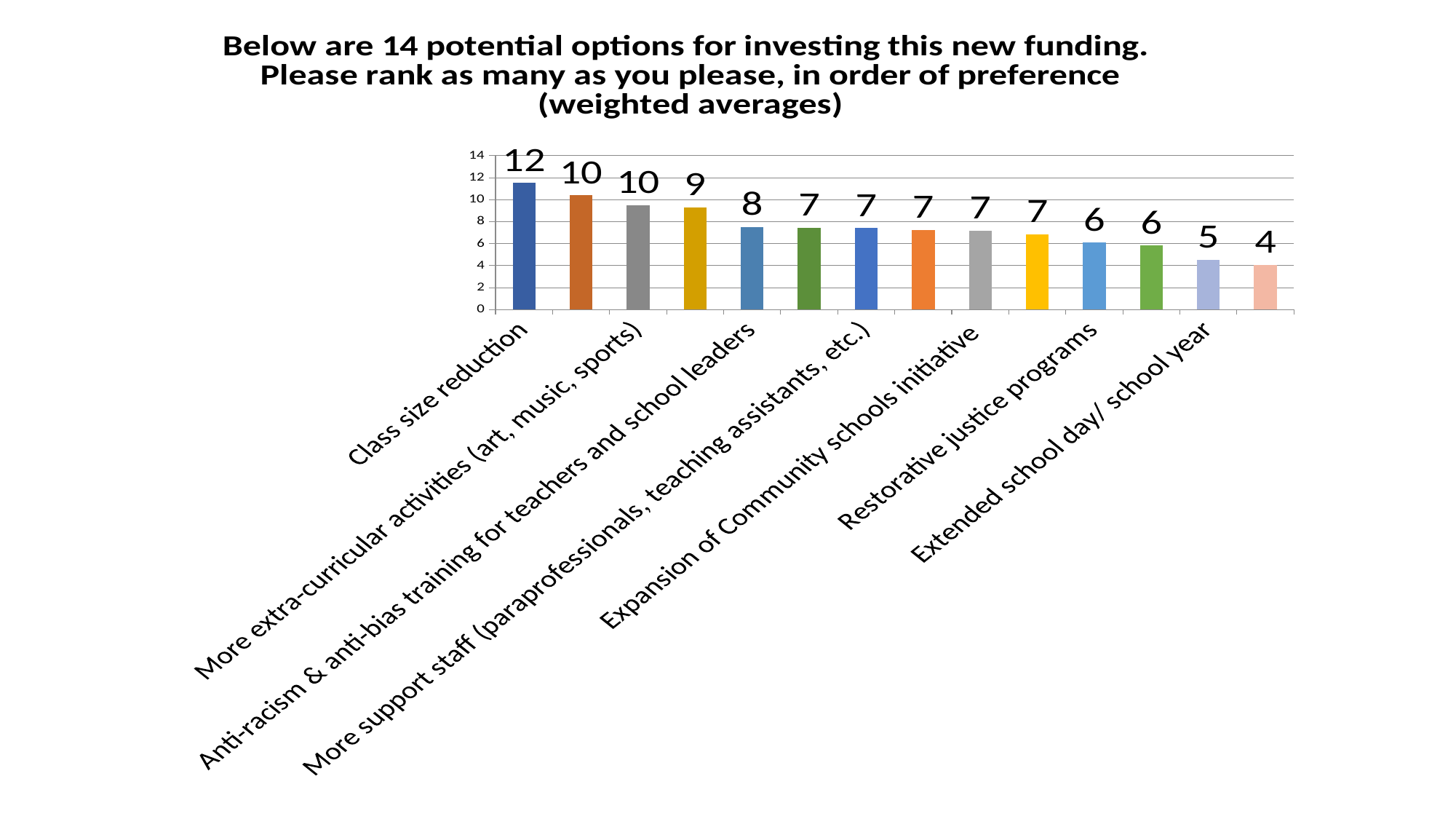
Do the values rise or fall from left to right across the chart? Fall What is the weighted average value for Restorative justice programs? 6 What is the lowest data label value shown on the chart? 4 What is the weighted average value for Anti-racism & anti-bias training for teachers and school leaders? 8 Which has a larger value: Class size reduction or Restorative justice programs? Class size reduction How many bars are plotted on the chart? 14 What kind of chart is shown on the slide? Bar chart Which option has the highest weighted average? Class size reduction What is the weighted average value for Extended school day/ school year? 5 What is the weighted average value for Class size reduction? 12 What is the difference between the values for Class size reduction and Extended school day/ school year? 7 What is the weighted average value for More extra-curricular activities (art, music, sports)? 10